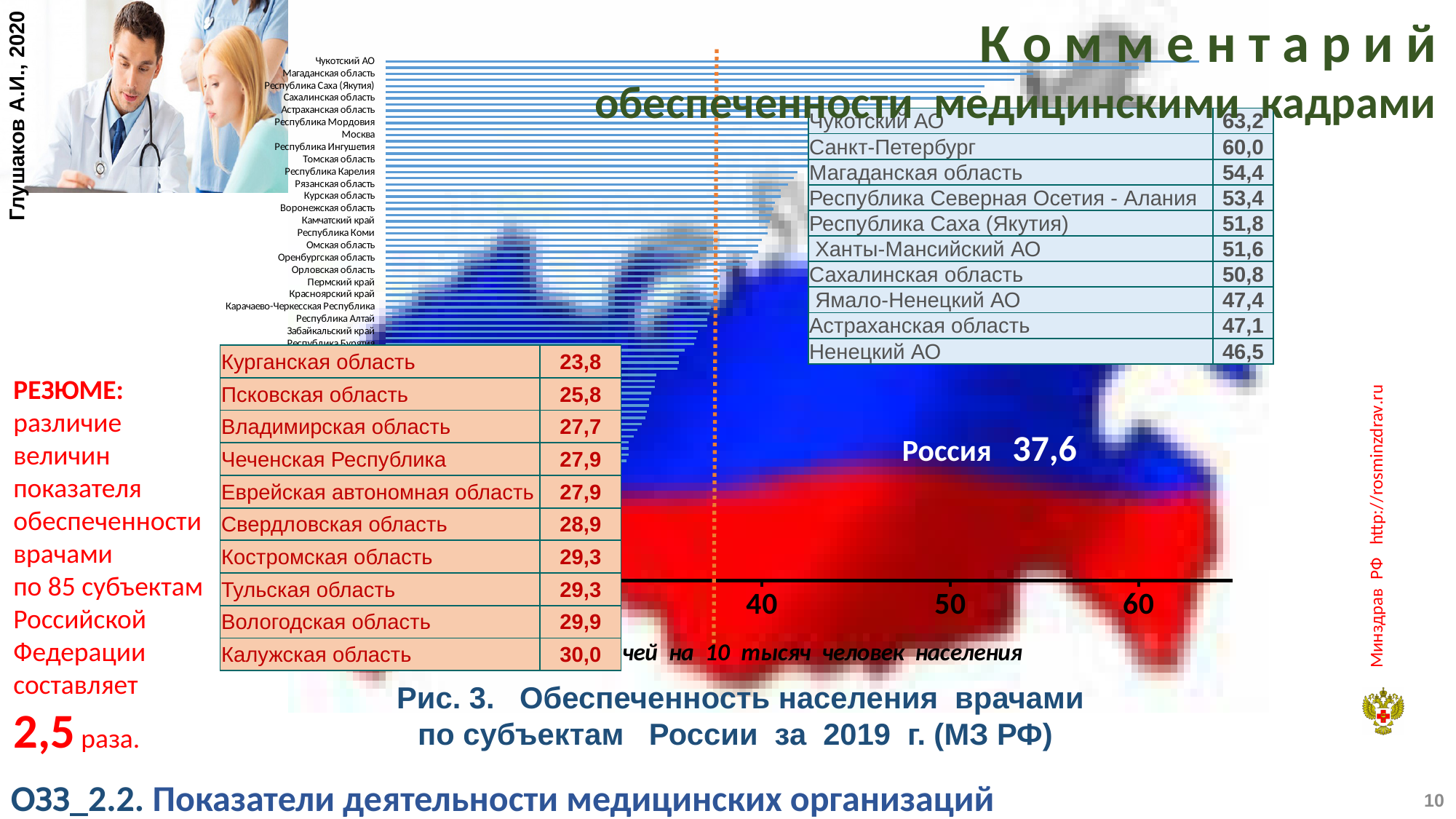
What is the value shown for Россия as a whole? 37,6 What kind of chart is shown on the slide (Рис. 3)? bar chart What is the difference between the values for Чукотский АО (63,2) and Курганская область (23,8)? 39,4 What is the value for Курганская область according to the table on the slide? 23,8 Is the bar for Москва greater or less than 40? greater How many subjects of the Russian Federation does the chart cover, according to the slide text? 85 Is the bar for Магаданская область greater or less than 50? greater What is the value for Санкт-Петербург according to the table on the slide? 60,0 For which year does the chart (Рис. 3) show data? 2019 Which region has the highest value in the chart of doctors per 10 thousand population? Чукотский АО What is the value for Чукотский АО according to the table on the slide? 63,2 Which has the larger value, Псковская область or Владимирская область? Владимирская область